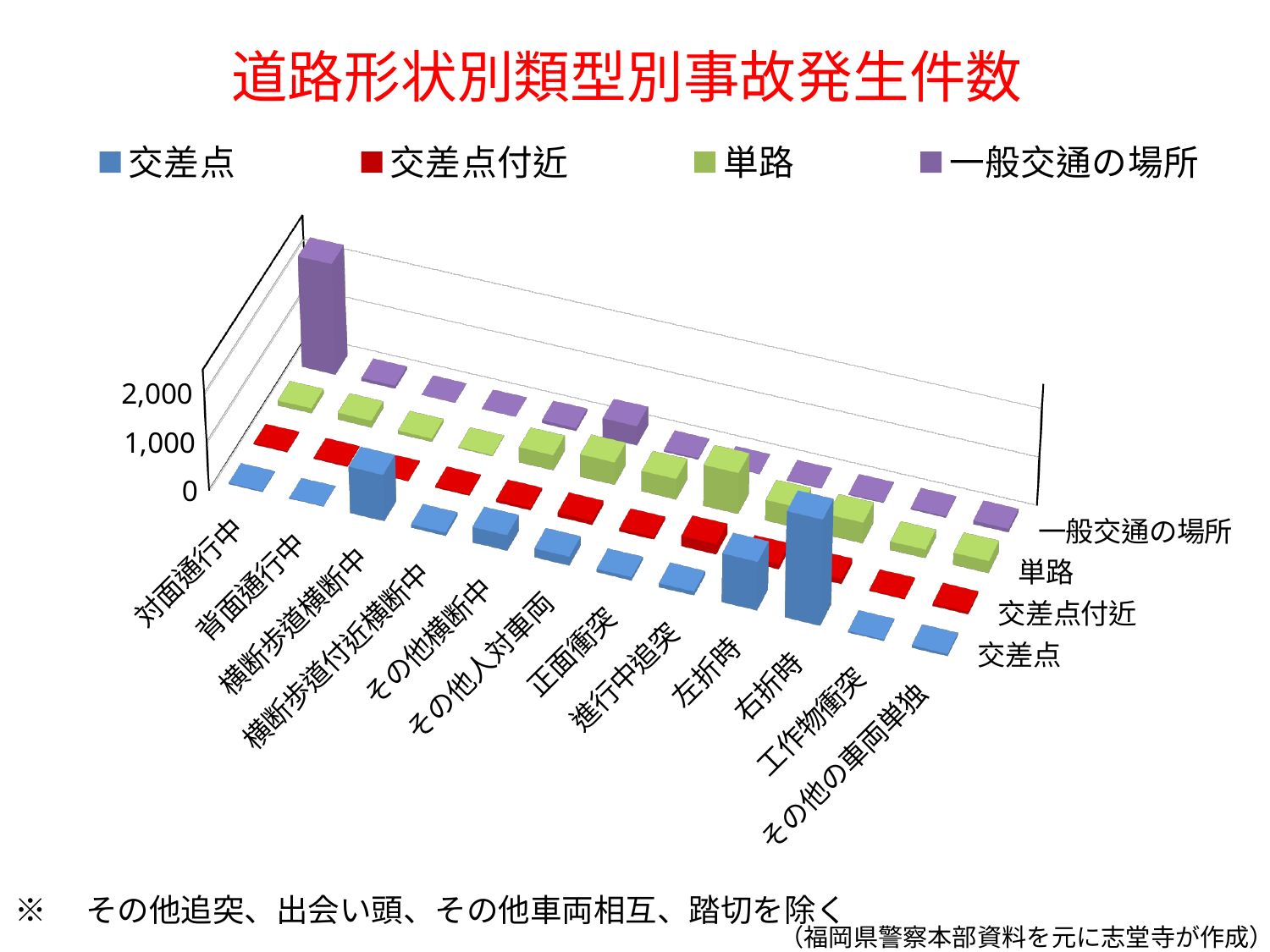
Which category has the highest value for the 一般交通の場所 series? 対面通行中 For the 交差点 series, which is larger: 右折時 or 左折時? 右折時 Is the value for 一般交通の場所 at 対面通行中 greater or less than 2,000? greater What is the title of the chart? 道路形状別類型別事故発生件数 Which category has the highest value for the 交差点 series? 右折時 Which colour represents the 交差点付近 series in the legend? red For the 一般交通の場所 series, which is larger: 対面通行中 or 正面衝突? 対面通行中 How many accident-type categories are shown along the x axis? 12 What kind of chart is shown on the slide? bar chart How many series does the legend list? 4 Is the value for 交差点 at 右折時 greater or less than 1,000? greater Is the value for 交差点付近 at 背面通行中 greater or less than 1,000? less